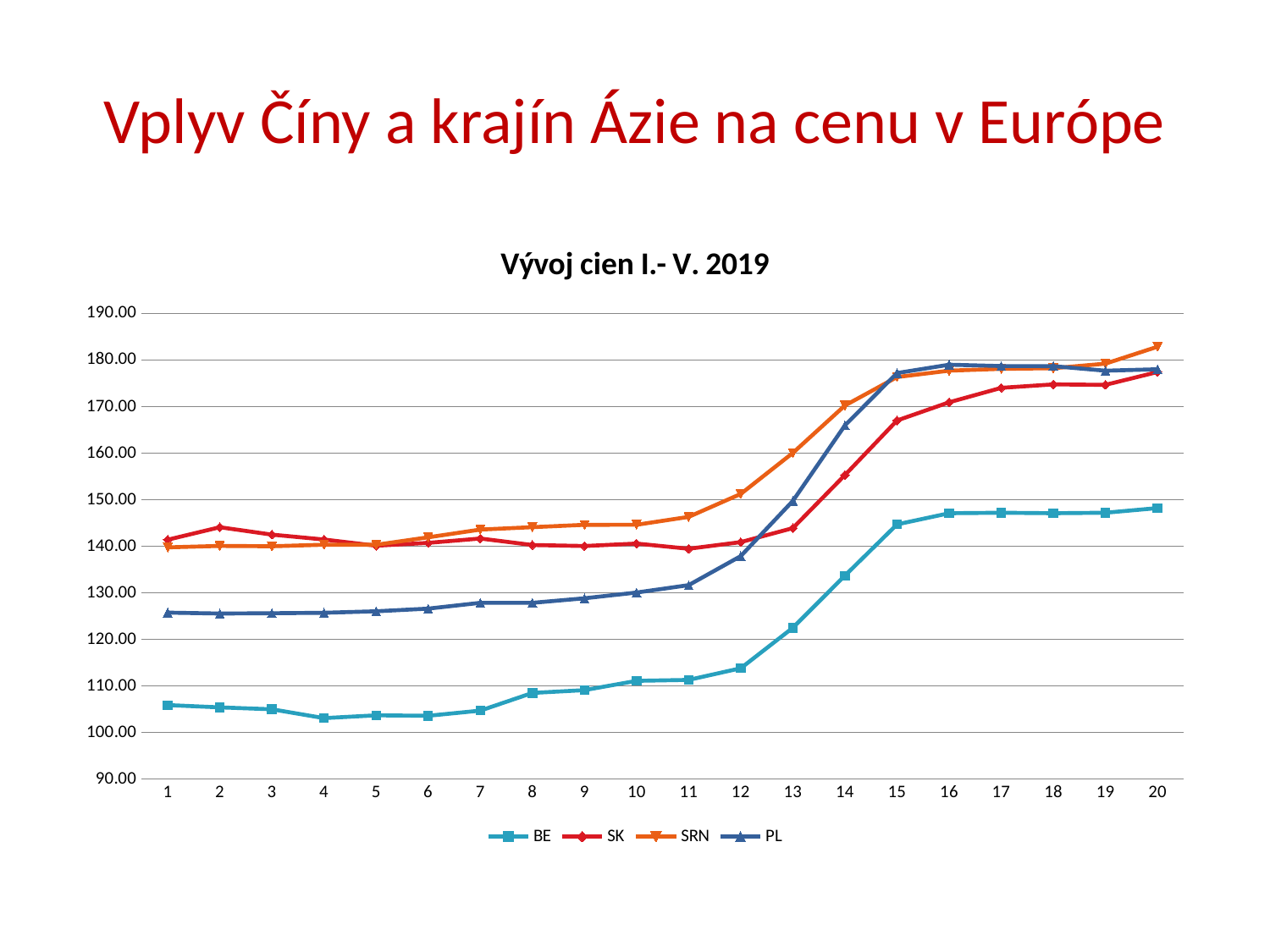
Is the value for BE at point 1 greater or less than 100? greater How many points are plotted along the x axis for each series? 20 Is the value for PL at point 12 greater or less than 140? less At point 14, which is larger, the value for PL or the value for SK? PL How many series does the legend list? 4 What is the title of the chart? Vývoj cien I.- V. 2019 Which series has the lowest value at point 10? BE Which series has the highest value at point 20? SRN Do the values of the BE series rise or fall from point 1 to point 20? rise Is the value for SRN at point 20 greater or less than 180? greater What kind of chart is shown on the slide? line chart